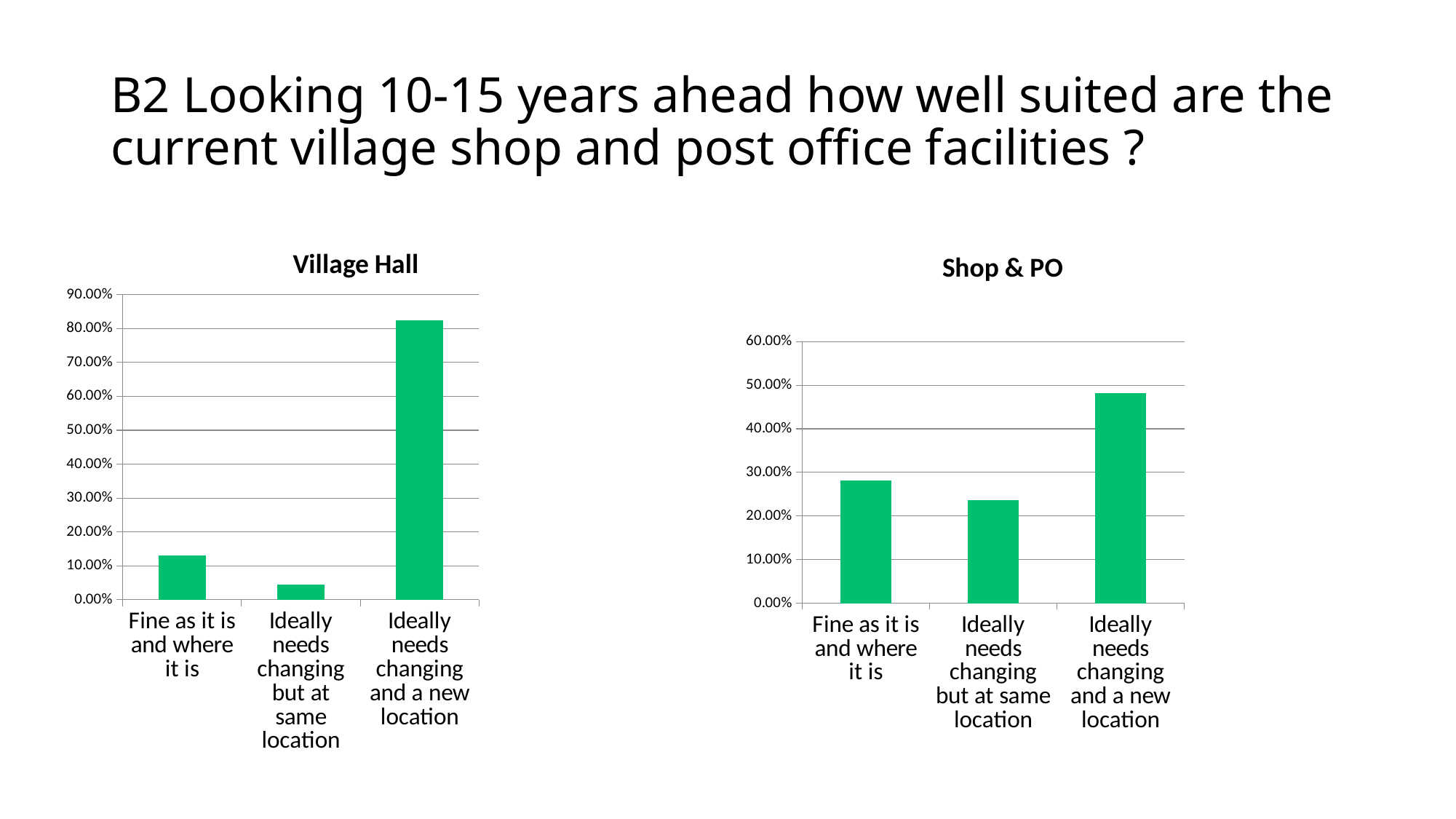
In the Village Hall chart, which category has the lowest value? Ideally needs changing but at same location In the Village Hall chart, is the value for 'Ideally needs changing and a new location' greater or less than 80.00%? greater In the Village Hall chart, which category has the highest value? Ideally needs changing and a new location In the Shop & PO chart, which category has the highest value? Ideally needs changing and a new location In the Shop & PO chart, is the value for 'Fine as it is and where it is' greater or less than 30.00%? less What type of chart is the Shop & PO chart? Bar chart In the Shop & PO chart, which category has the lowest value? Ideally needs changing but at same location What is the title of the chart on the right side of the slide? Shop & PO In the Village Hall chart, is the value for 'Fine as it is and where it is' greater or less than 20.00%? less In the Shop & PO chart, which is larger: 'Fine as it is and where it is' or 'Ideally needs changing but at same location'? Fine as it is and where it is How many categories are shown in the Village Hall chart? 3